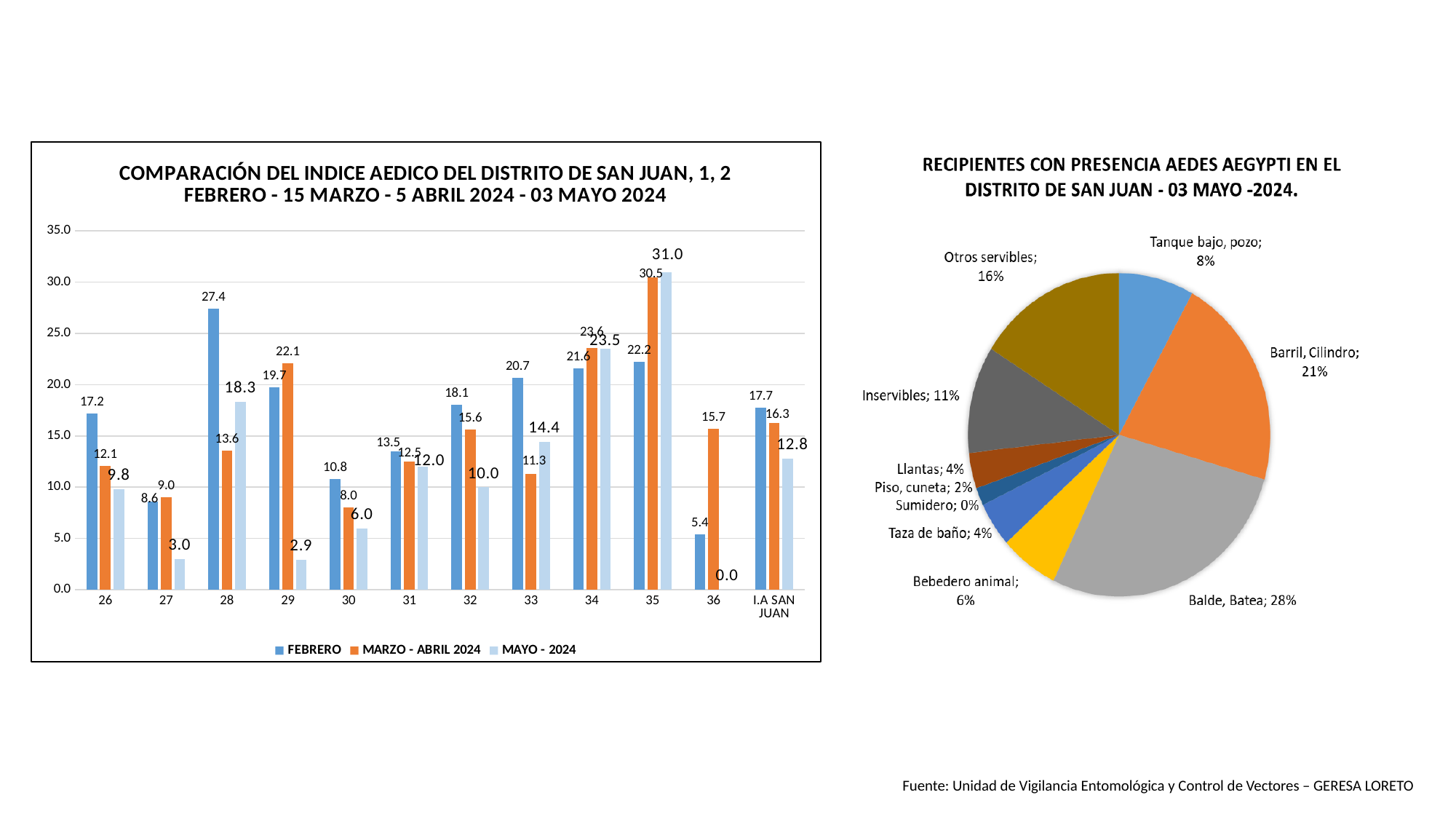
In the left bar chart, what is the difference between the FEBRERO and MAYO - 2024 values for category 29? 16.8 How many series does the legend of the left bar chart list? 3 How many categories are shown on the x axis of the left bar chart? 12 In the right pie chart, which category has the largest slice? Balde, Batea In the left bar chart, which category has the highest MAYO - 2024 value? 35 In the left bar chart, what is the MARZO - ABRIL 2024 value for I.A SAN JUAN? 16.3 In the left bar chart, what is the MAYO - 2024 value for category 36? 0.0 In the left bar chart, which is larger for category 33: the FEBRERO value or the MARZO - ABRIL 2024 value? FEBRERO What kind of chart is the chart on the right of the slide? Pie chart In the left bar chart, which category has the lowest FEBRERO value? 36 In the right pie chart (RECIPIENTES CON PRESENCIA AEDES AEGYPTI), what share does Balde, Batea have? 28% In the left bar chart (COMPARACIÓN DEL INDICE AEDICO), what is the FEBRERO value for category 28? 27.4